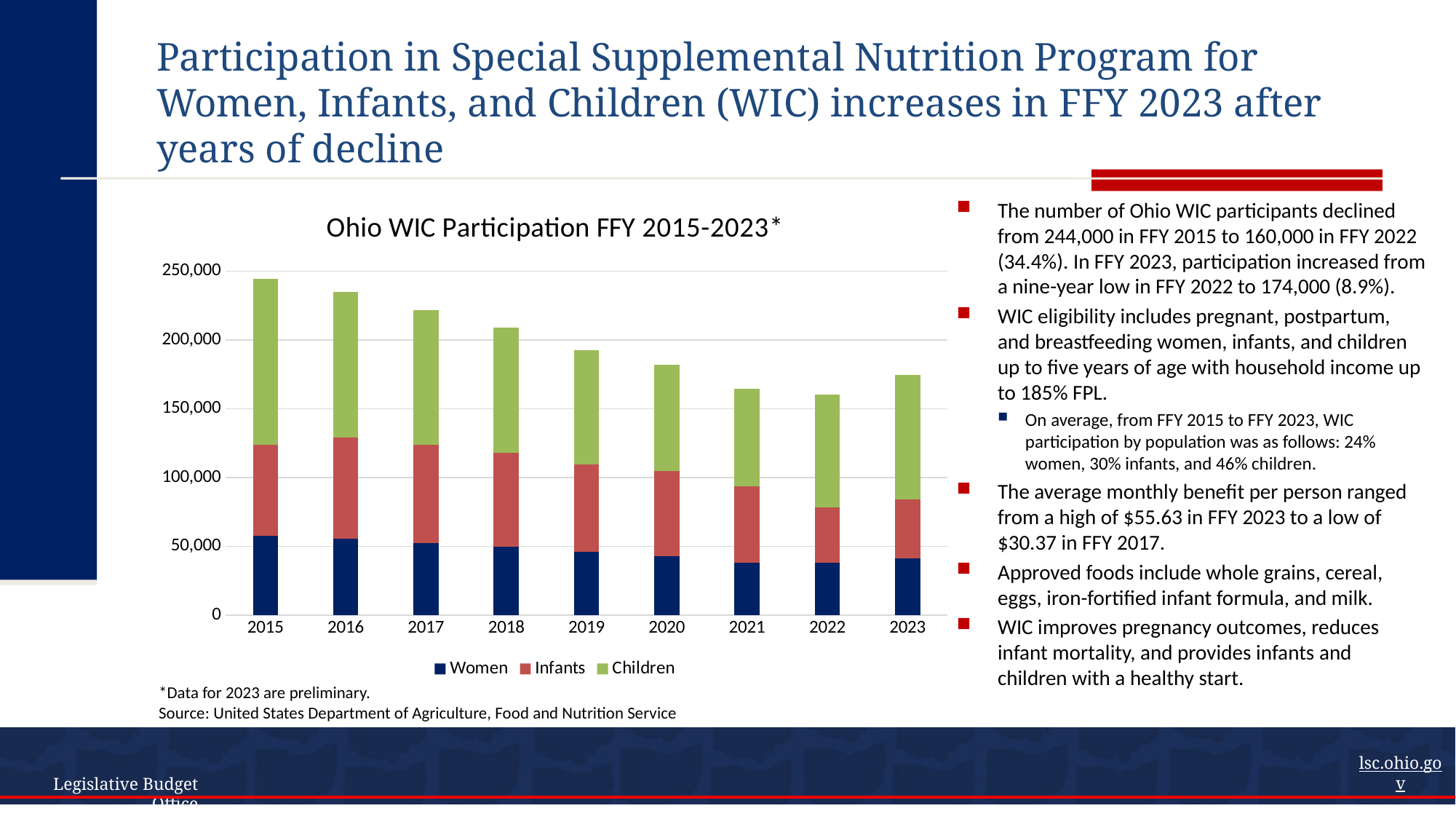
What kind of chart is shown on the slide? Stacked bar chart What is the title of the chart? Ohio WIC Participation FFY 2015-2023* How does total WIC participation change from 2015 to 2022 in the chart? It falls Is the total participation for 2015 greater or less than 200,000? greater How many series does the chart legend list? 3 Which year has the highest total WIC participation in the chart? 2015 How many years are shown on the x axis of the chart? 9 Is the total participation for 2022 greater or less than 200,000? less Which series are listed in the chart legend? Women, Infants, Children Which year has the lowest total WIC participation in the chart? 2022 Is the value for Women in 2021 greater or less than 50,000? less Which year has the larger total participation, 2015 or 2023? 2015